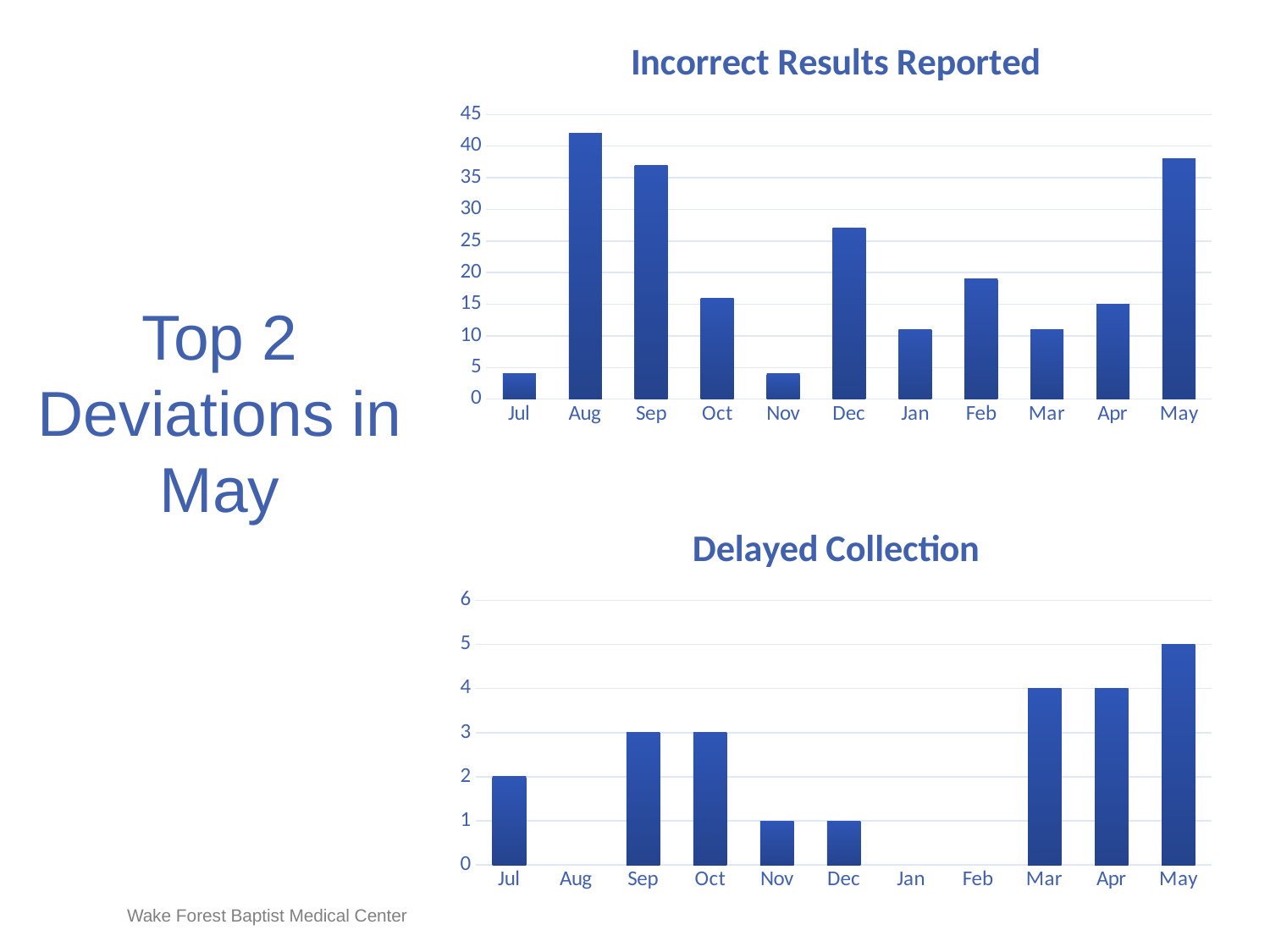
What type of chart is the 'Incorrect Results Reported' chart? bar chart In the 'Delayed Collection' chart, which is larger, the value for Mar or the value for Nov? Mar In the 'Incorrect Results Reported' chart, is the value for Aug greater or less than 40? greater In the 'Delayed Collection' chart, what is the value for May? 5 In the 'Incorrect Results Reported' chart, which month has the highest value? Aug How many months are shown on the x axis of the 'Incorrect Results Reported' chart? 11 In the 'Delayed Collection' chart, what is the difference between the values for May and Jul? 3 In the 'Delayed Collection' chart, which month has the highest value? May In the 'Incorrect Results Reported' chart, is the value for Apr greater or less than 20? less In the 'Delayed Collection' chart, what is the value for Jul? 2 In the 'Incorrect Results Reported' chart, is the value for Dec greater or less than 25? greater In the 'Incorrect Results Reported' chart, which is larger, the value for Sep or the value for Dec? Sep